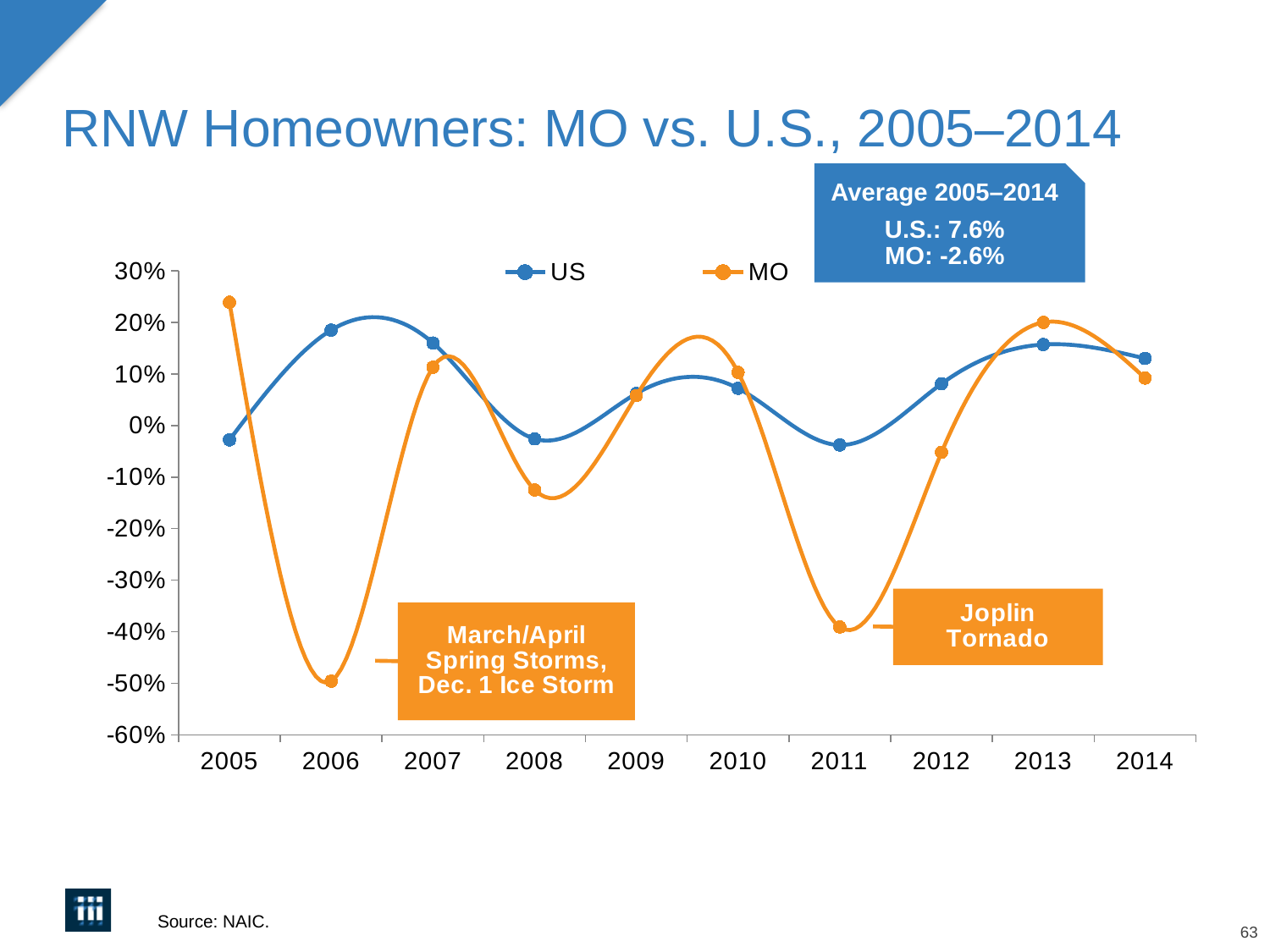
How many series does the legend list? 2 How many years are plotted along the x axis? 10 In which year is the MO series at its lowest value? 2006 In which year is the US series at its highest value? 2006 Is the MO value for 2005 greater or less than 20%? greater Is the MO value for 2006 greater or less than -40%? less In 2011, which series has the larger value, US or MO? US Does the US series rise or fall from 2011 to 2013? rise According to the box on the slide, what is the MO average for 2005–2014? -2.6% What type of chart is shown on the slide? line chart Is the MO value for 2011 greater or less than -30%? less